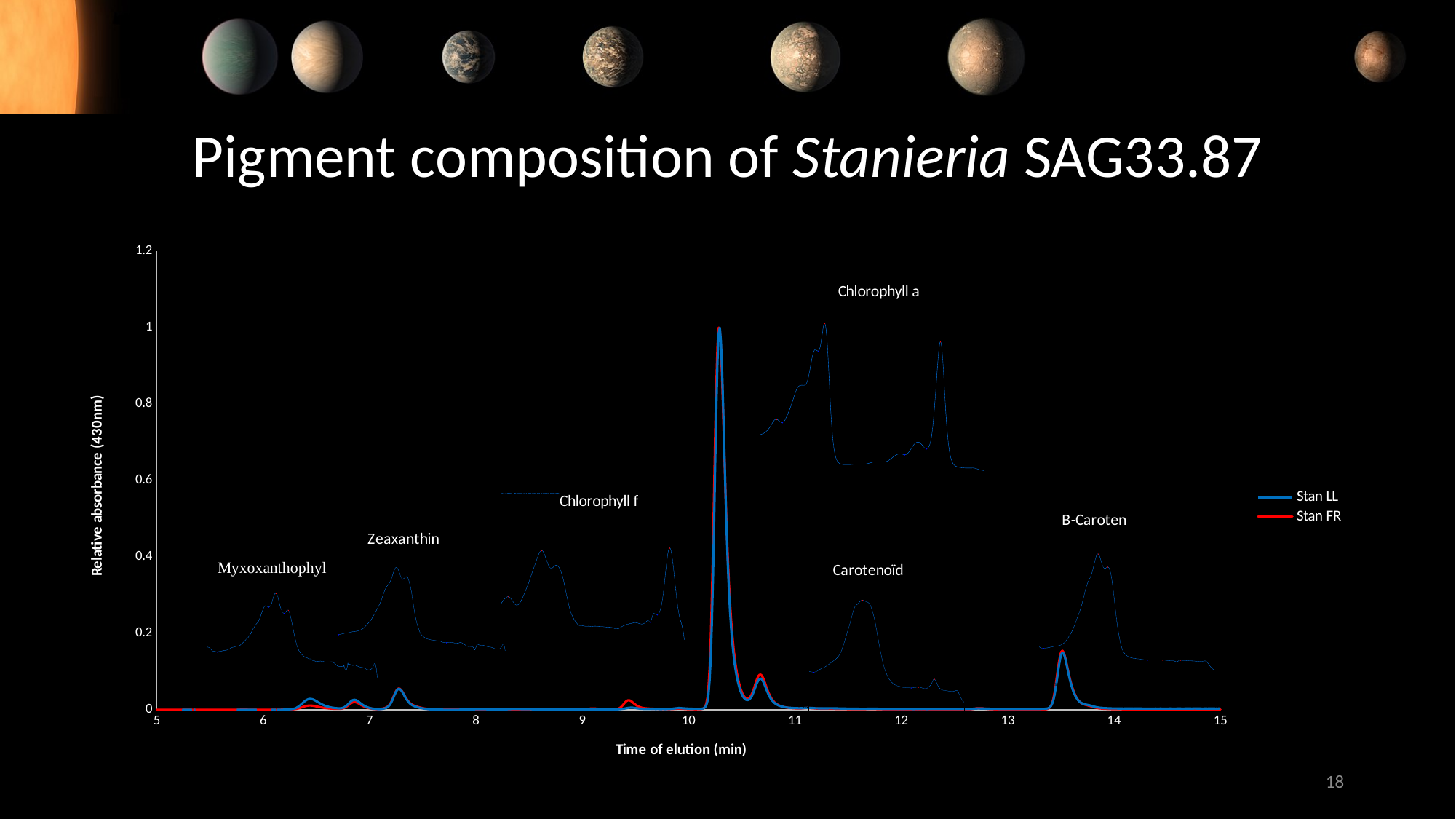
At the small peak near 9.4 min, which series reaches a higher absorbance, Stan LL or Stan FR? Stan FR Does the Stan LL line rise or fall between about 10.3 min and 11 min? fall What are the two series named in the legend? Stan LL and Stan FR Is the tallest peak of the chromatogram, located between 10 and 11 min, greater or less than 0.8 in relative absorbance? greater What kind of chart is shown on the slide? line chart At the small peak near 10.7 min, which series reaches a higher absorbance, Stan LL or Stan FR? Stan FR Is the tallest peak of the chart located between 10 and 11 min on the x axis? yes How many series does the legend list? 2 Is the Stan LL peak near 7.3 min greater or less than 0.2 in relative absorbance? less What is the title of the x axis? Time of elution (min) Is the Stan LL peak near 13.5 min greater or less than 0.2 in relative absorbance? less